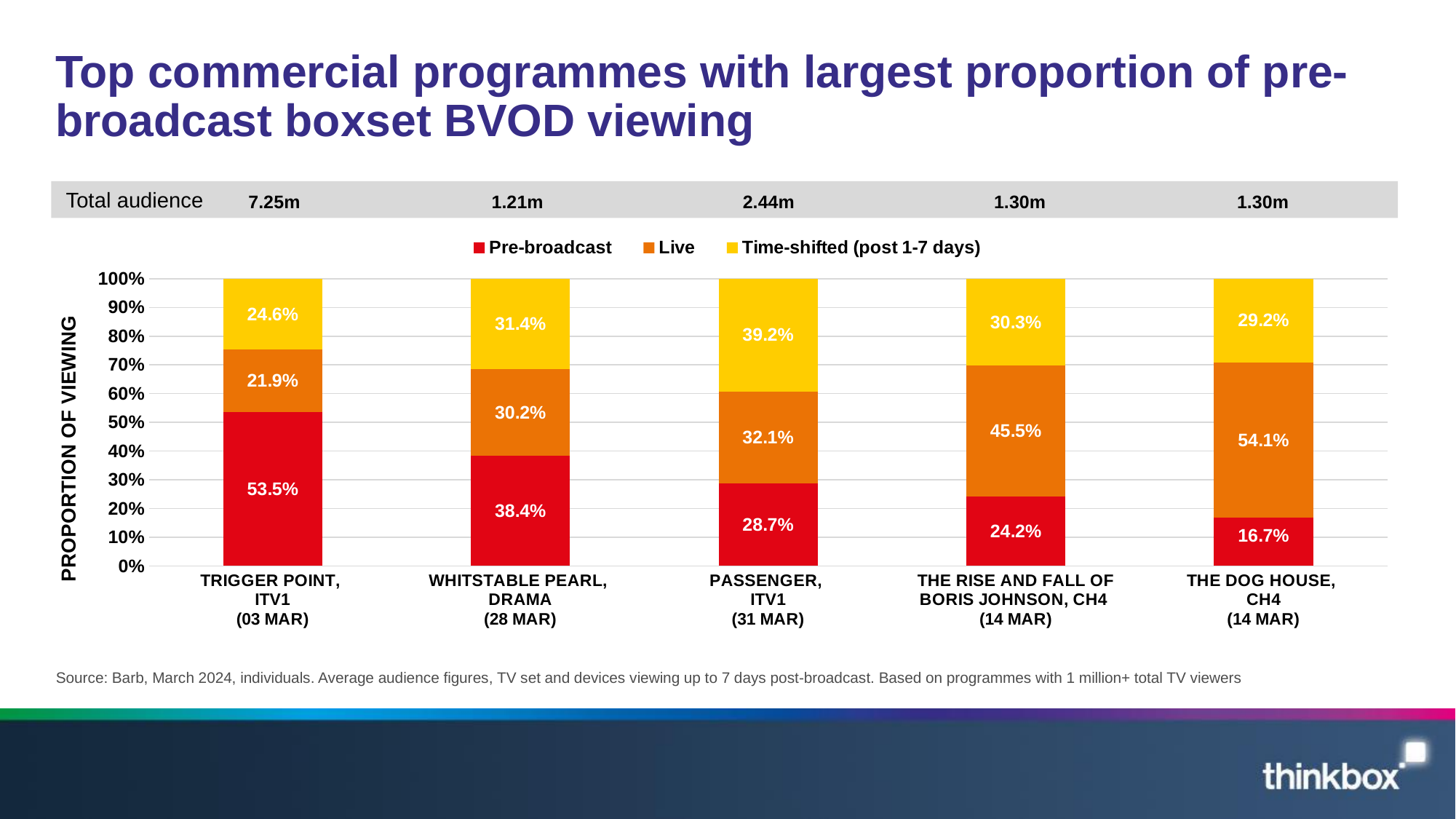
What is the total audience shown for Trigger Point, ITV1 (03 Mar)? 7.25m What is the Pre-broadcast proportion of viewing for Trigger Point, ITV1 (03 Mar)? 53.5% How many percentage points higher is the Live proportion for The Dog House than for Trigger Point? 32.2 percentage points Which programme has the highest Pre-broadcast proportion of viewing? Trigger Point, ITV1 (03 Mar) How many programmes are shown on the chart? 5 How many series does the legend list? 3 What is the Live proportion of viewing for The Dog House, CH4 (14 Mar)? 54.1% Which programme has the lowest Pre-broadcast proportion of viewing? The Dog House, CH4 (14 Mar) What kind of chart is shown on the slide? Stacked bar chart Which colour represents the Live series in the legend? Orange Which has the larger Live proportion: Whitstable Pearl, Drama or Passenger, ITV1? Passenger, ITV1 What is the Time-shifted (post 1-7 days) proportion for Passenger, ITV1 (31 Mar)? 39.2%